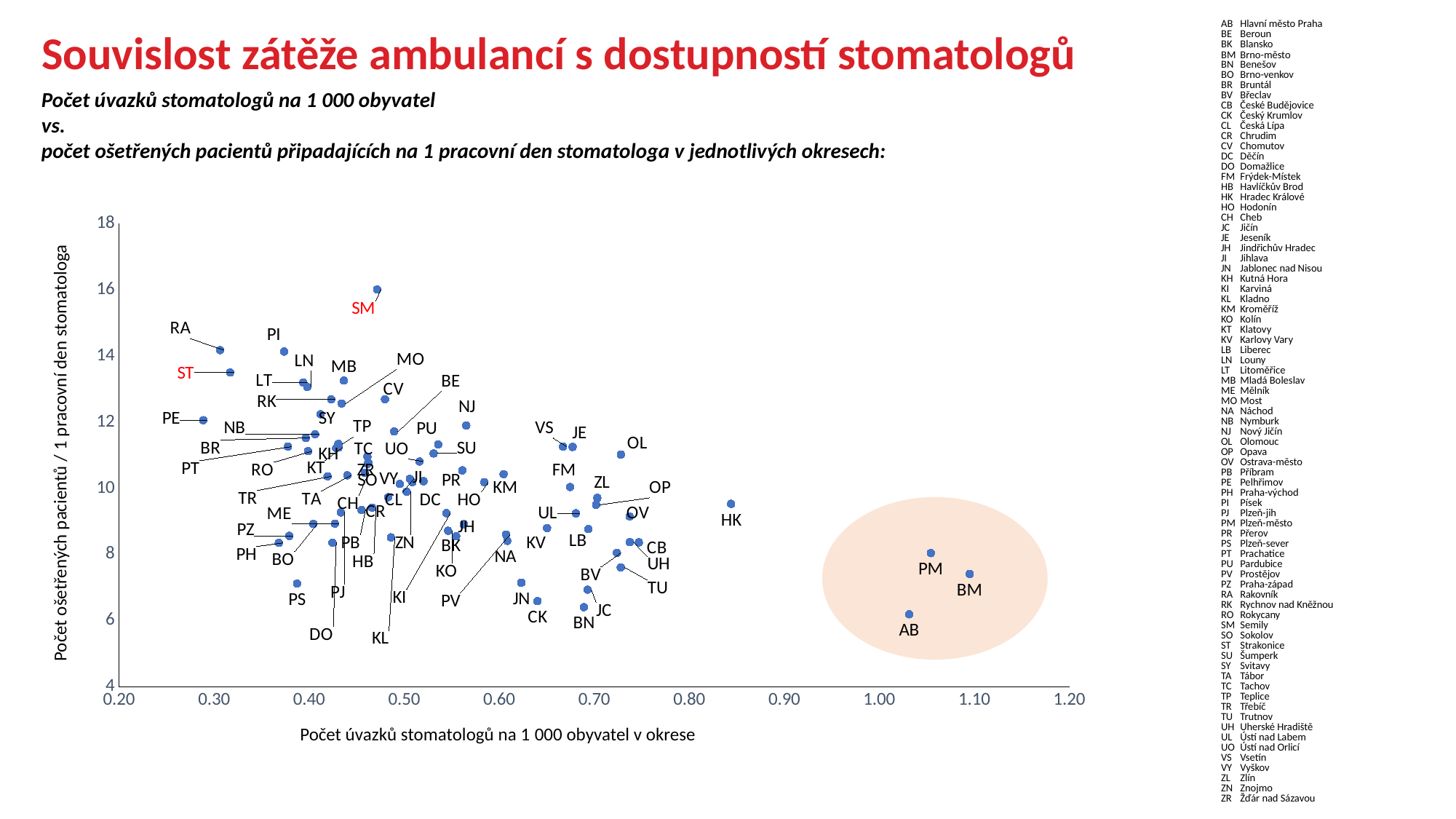
Which district has the highest value on the vertical axis (patients per working day)? SM Is the vertical-axis value for AB greater or less than 8? less Which district has the highest value on the horizontal axis (dentist FTEs per 1 000 inhabitants)? BM What kind of chart is shown on the slide? scatter chart Which has the larger horizontal-axis value, BM or PM? BM Is the vertical-axis value for SM greater or less than 14? greater Do the vertical-axis values generally rise or fall as the horizontal-axis value increases? fall What is the title of the horizontal axis? Počet úvazků stomatologů na 1 000 obyvatel v okrese Is the horizontal-axis value for BM greater or less than 1.00? greater Which has the higher vertical-axis value, PE or HK? PE Which district has the lowest value on the horizontal axis? PE